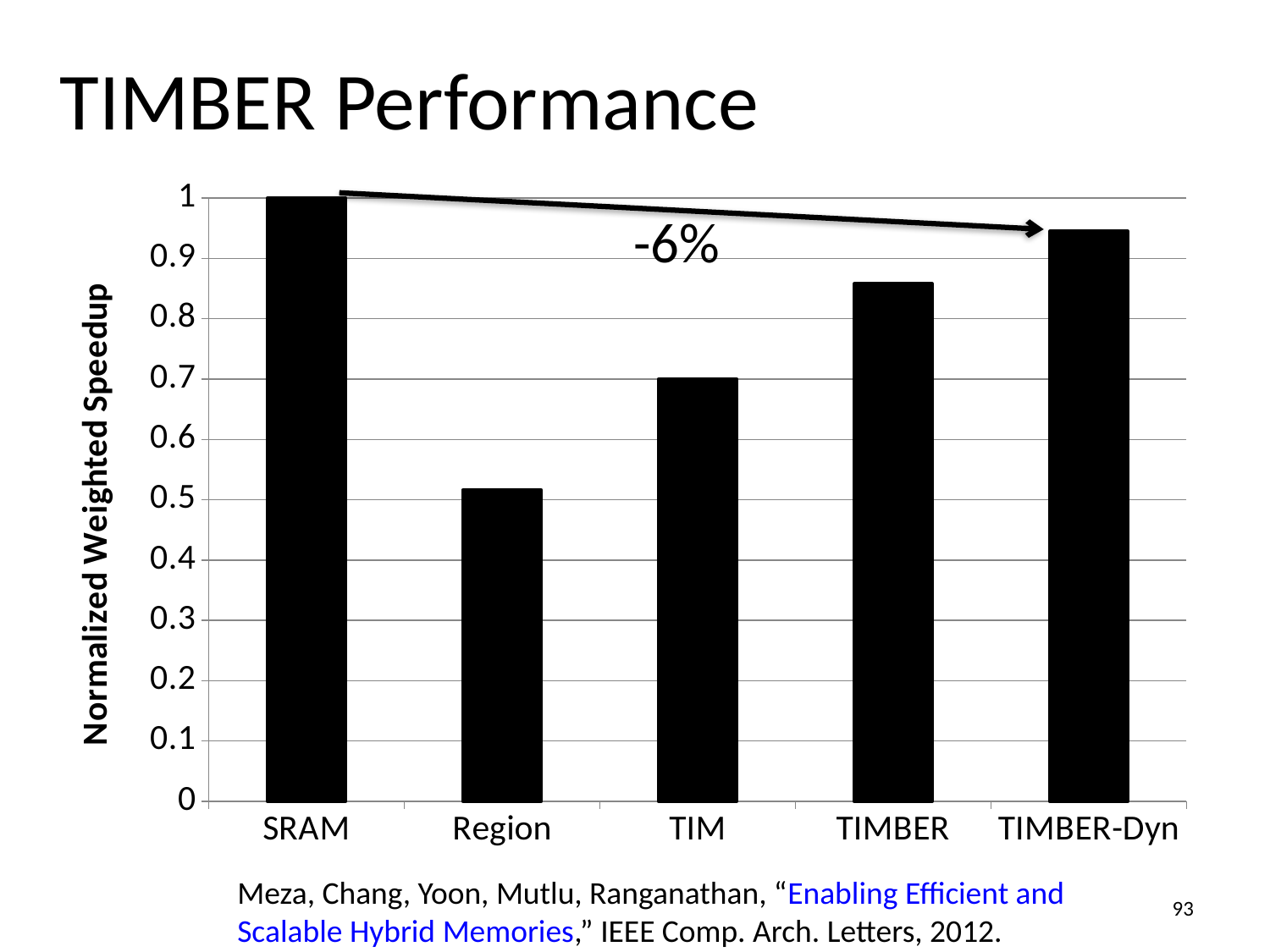
What is the label on the y axis of the chart? Normalized Weighted Speedup Which has a higher normalized weighted speedup, TIMBER or TIMBER-Dyn? TIMBER-Dyn Which category has the highest normalized weighted speedup? SRAM What kind of chart is shown on the slide? bar chart Which has a higher normalized weighted speedup, TIM or TIMBER? TIMBER What is the normalized weighted speedup for SRAM? 1 How many categories are shown on the x axis of the chart? 5 What percentage is written next to the arrow from the SRAM bar to the TIMBER-Dyn bar? -6% Which category has the lowest normalized weighted speedup? Region Is the value for TIMBER-Dyn greater or less than 0.9? greater Is the value for TIMBER greater or less than 0.8? greater Is the value for Region greater or less than 0.6? less